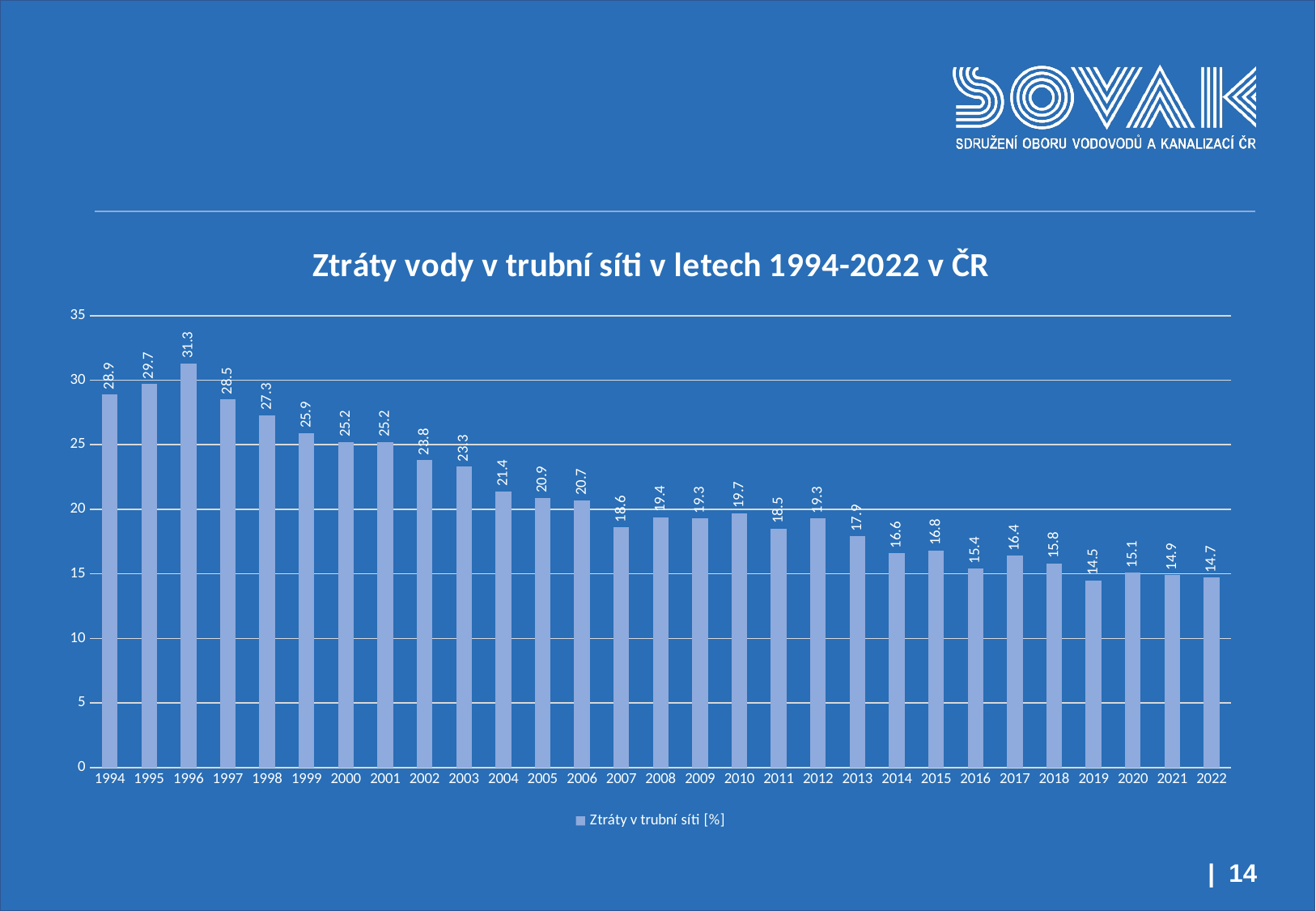
Which year has the lowest value? 2019 What kind of chart is shown? bar chart What is the difference between the values for 1994 and 2022? 14.2 Do the values generally rise or fall from 1994 to 2022? fall How many series does the legend list? 1 How many years are shown on the x axis? 29 What is the value for 1996? 31.3 Which year has the highest value? 1996 What is the value for 2022? 14.7 What is the value for 2007? 18.6 Which is larger, the value for 2010 or the value for 2011? 2010 Is the value for 2004 greater or less than 20? greater